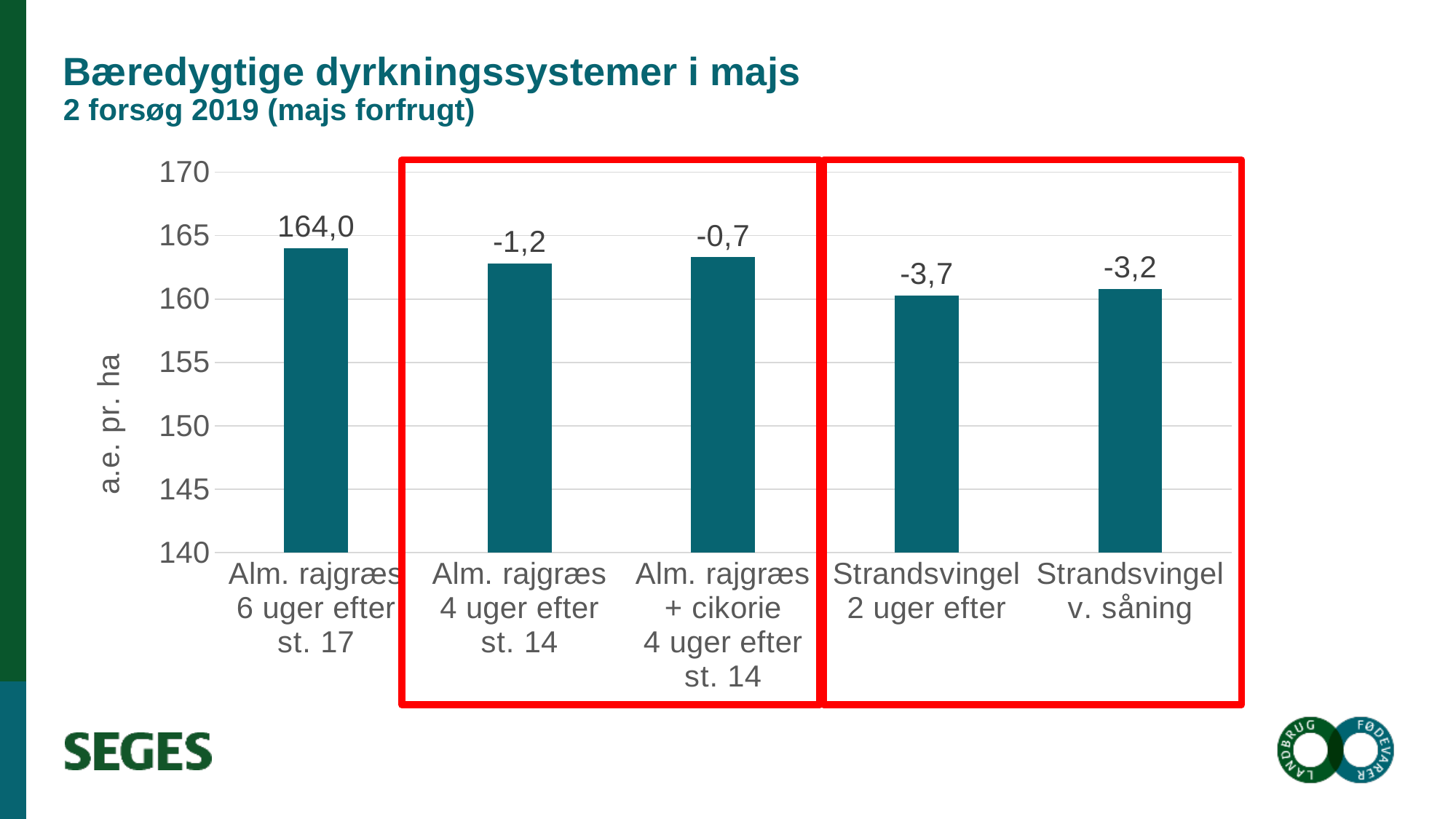
What is the label on the vertical axis of the chart? a.e. pr. ha What data label is shown above the bar for 'Alm. rajgræs 4 uger efter st. 14'? -1,2 Is the bar for 'Alm. rajgræs 4 uger efter st. 14' greater or less than 160? greater What data label is shown above the bar for 'Strandsvingel 2 uger efter'? -3,7 How many bars (categories) are plotted in the chart? 5 What data label is shown above the bar for 'Alm. rajgræs + cikorie 4 uger efter st. 14'? -0,7 Which category has the shortest bar? Strandsvingel 2 uger efter What data label is shown above the bar for 'Strandsvingel v. såning'? -3,2 What value is printed above the bar for 'Alm. rajgræs 6 uger efter st. 17'? 164,0 Is the bar for 'Strandsvingel 2 uger efter' greater or less than 165? less What type of chart is shown on the slide? bar chart Which category has the tallest bar? Alm. rajgræs 6 uger efter st. 17